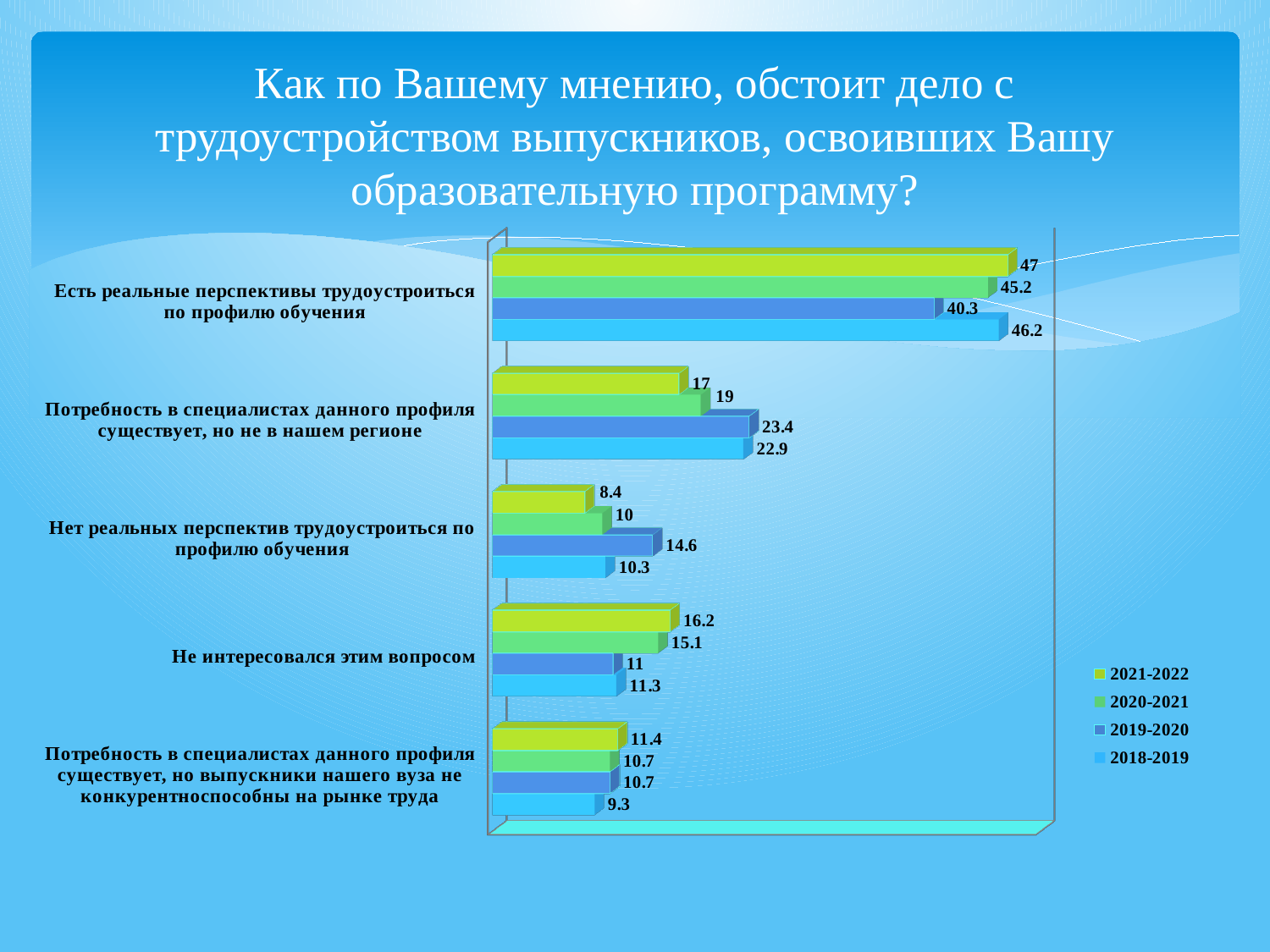
Which category has the lowest value for the 2021-2022 series? Нет реальных перспектив трудоустроиться по профилю обучения What is the value for 2020-2021 in the category "Потребность в специалистах данного профиля существует, но выпускники нашего вуза не конкурентноспособны на рынке труда"? 10.7 Which category has the highest value for the 2018-2019 series? Есть реальные перспективы трудоустроиться по профилю обучения What is the value for 2021-2022 in the category "Есть реальные перспективы трудоустроиться по профилю обучения"? 47 What is the value for 2018-2019 in the category "Нет реальных перспектив трудоустроиться по профилю обучения"? 10.3 How many series does the legend list? 4 What is the difference between the 2021-2022 and 2019-2020 values in the category "Есть реальные перспективы трудоустроиться по профилю обучения"? 6.7 How many categories are shown on the chart? 5 In the category "Не интересовался этим вопросом", which is larger: the value for 2021-2022 or for 2018-2019? 2021-2022 Which series is shown in the legend with the light blue colour? 2018-2019 What is the value for 2019-2020 in the category "Потребность в специалистах данного профиля существует, но не в нашем регионе"? 23.4 What type of chart is shown on the slide? bar chart